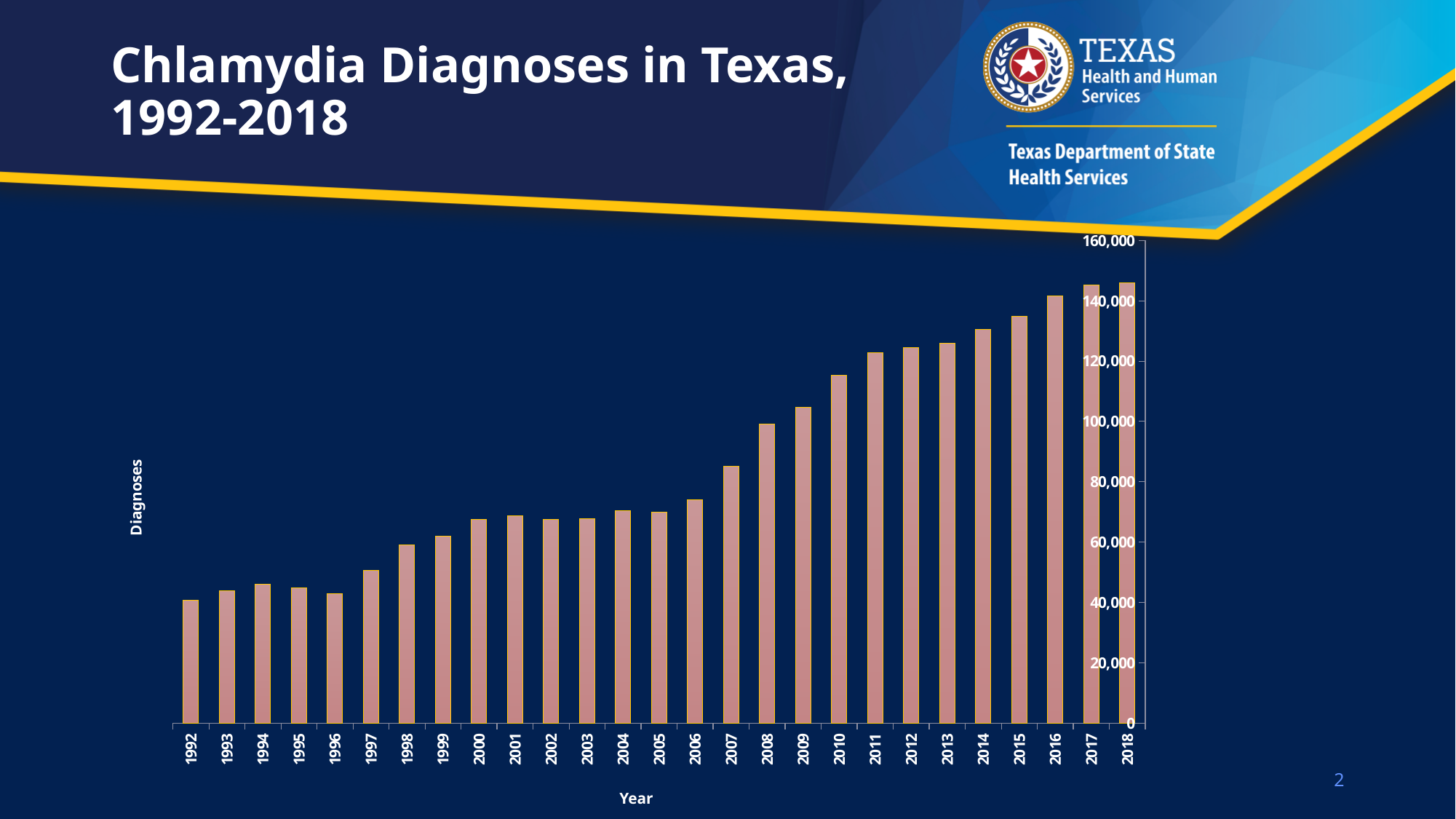
What is the title of the slide? Chlamydia Diagnoses in Texas, 1992-2018 What is the label on the vertical axis? Diagnoses Which year has more diagnoses, 2000 or 2010? 2010 Is the value for 2005 greater or less than 80,000? less What kind of chart is shown on the slide? bar chart Overall, do chlamydia diagnoses rise or fall from 1992 to 2018? rise How many years (bars) are plotted on the chart? 27 Is the value for 2014 greater or less than 120,000? greater Is the value for 1992 greater or less than 60,000? less Which year has the lowest number of diagnoses? 1992 Which year has more diagnoses, 2006 or 2007? 2007